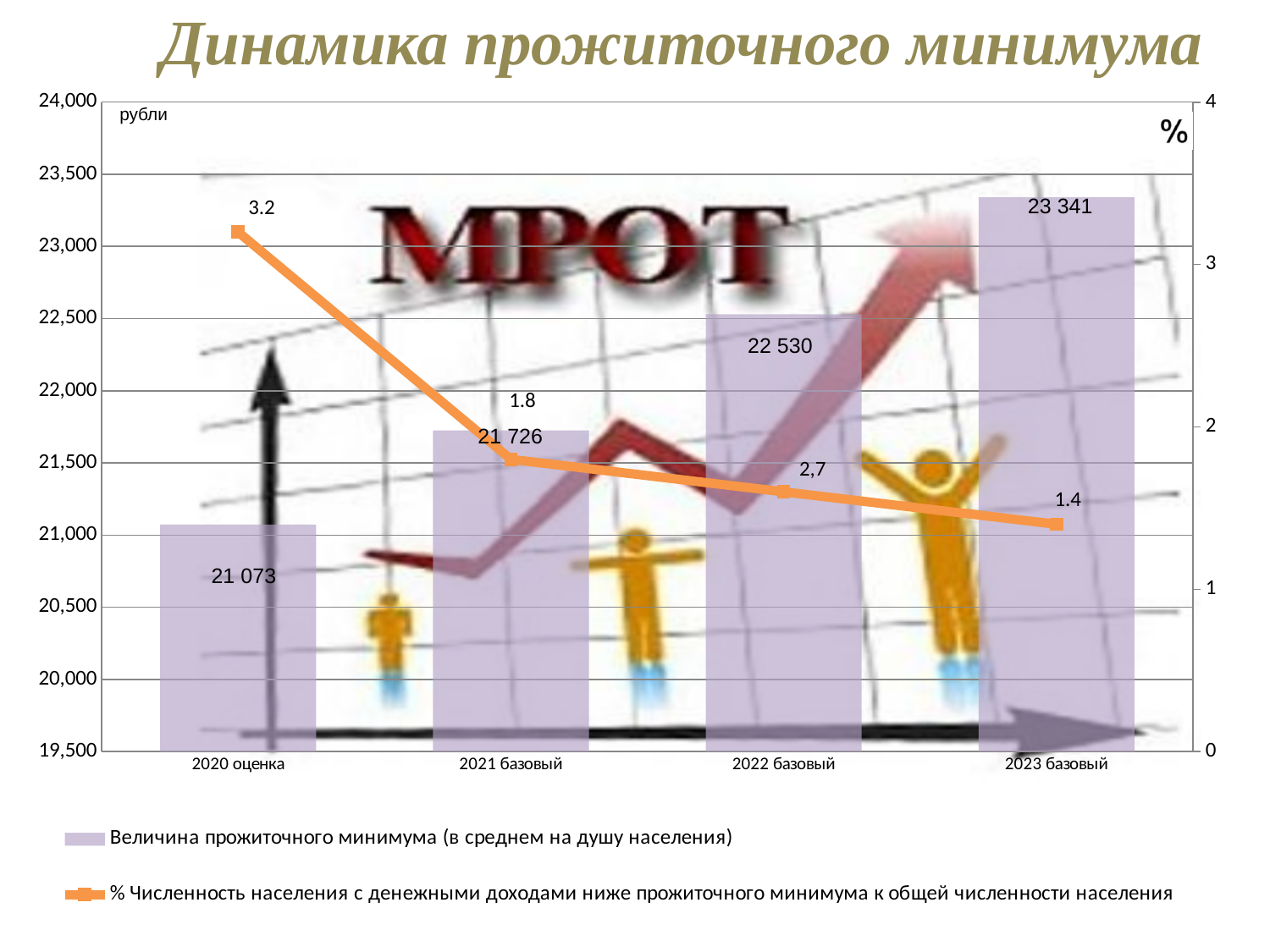
What is the value of the subsistence minimum (Величина прожиточного минимума) bar for 2023 базовый? 23 341 Which category has the lowest subsistence minimum bar? 2020 оценка What is the difference between the orange line values for 2020 оценка and 2021 базовый? 1.4 What is the value of the subsistence minimum bar for 2020 оценка? 21 073 Which category has the highest subsistence minimum bar? 2023 базовый How many series does the legend list? 2 Do the subsistence minimum bars rise or fall from 2020 to 2023? rise What is the value of the orange line for 2023 базовый? 1.4 Which has a larger subsistence minimum bar, 2021 базовый or 2022 базовый? 2022 базовый What is the difference between the subsistence minimum bars for 2023 базовый and 2020 оценка? 2 268 How many categories are shown on the x axis? 4 What is the value of the orange line (% population with incomes below the subsistence minimum) for 2020 оценка? 3.2